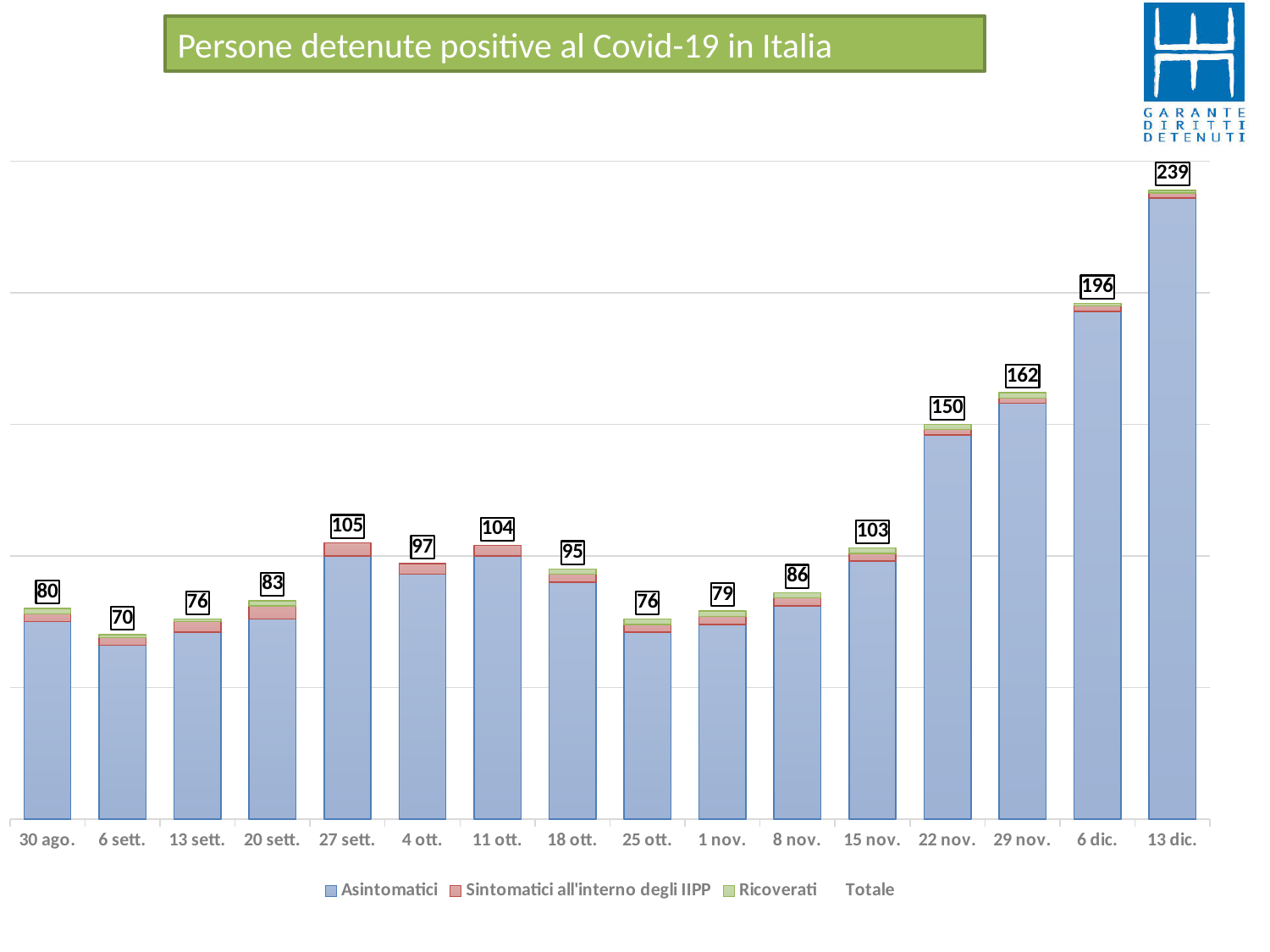
Which date has the highest total? 13 dic. What is the total value shown for 22 nov.? 150 How many entries does the legend list? 4 What is the difference between the totals for 29 nov. and 22 nov.? 12 What is the total value shown for 13 dic.? 239 What is the title of the slide? Persone detenute positive al Covid-19 in Italia Which is larger, the total for 4 ott. or the total for 11 ott.? 11 ott. What is the difference between the totals for 13 dic. and 6 dic.? 43 What kind of chart is shown on the slide? Stacked bar chart Which date has the lowest total? 6 sett. How many dates are shown on the x axis? 16 What is the total value shown for 27 sett.? 105